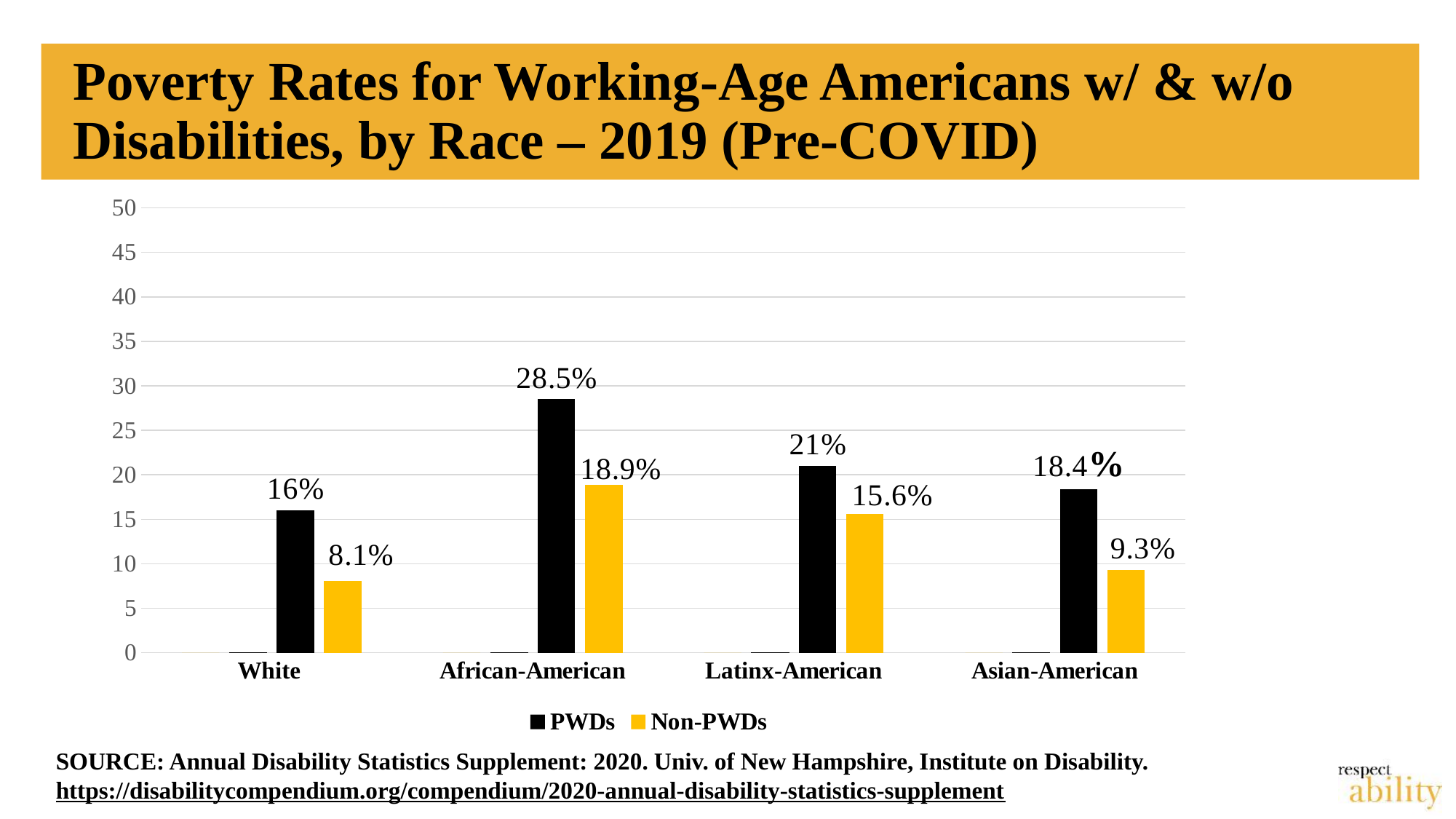
Which race category has the lowest poverty rate for Non-PWDs? White What is the poverty rate for PWDs in the Asian-American category? 18.4% How many race categories are shown on the x axis? 4 What is the poverty rate for Non-PWDs in the White category? 8.1% Which colour represents the Non-PWDs series? Yellow Which race category has the highest poverty rate for PWDs? African-American Which is larger: the Non-PWDs rate for African-American or the PWDs rate for White? Non-PWDs rate for African-American What kind of chart is shown on the slide? Bar chart What is the poverty rate for PWDs in the African-American category? 28.5% How many series does the legend list? 2 What is the poverty rate for Non-PWDs in the Latinx-American category? 15.6% What is the difference between the PWDs and Non-PWDs poverty rates in the Latinx-American category? 5.4%